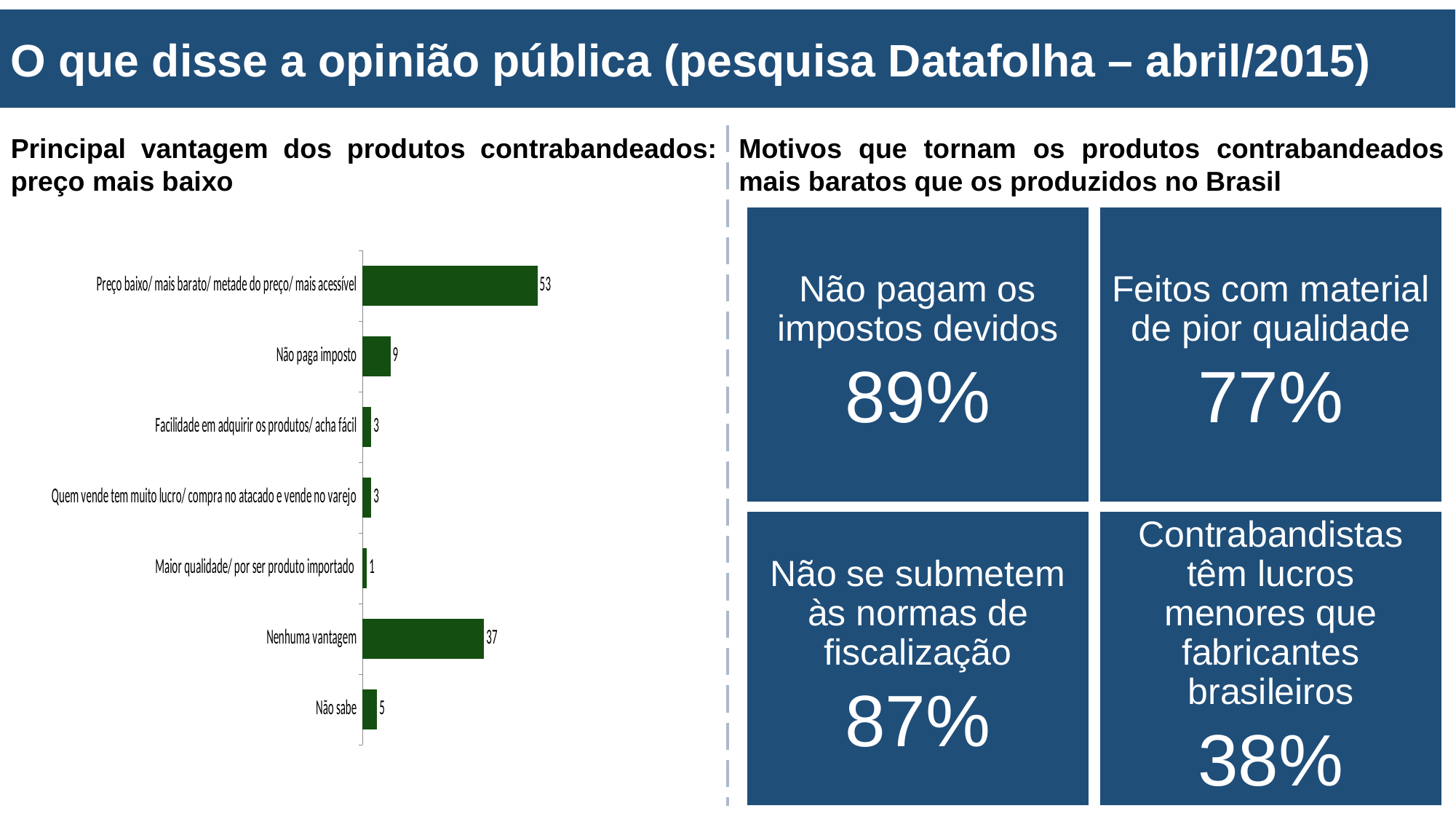
What is the difference between the values for "Preço baixo/ mais barato/ metade do preço/ mais acessível" and "Nenhuma vantagem"? 16 Which category has the lowest value in the bar chart? Maior qualidade/ por ser produto importado What is the value for "Nenhuma vantagem"? 37 What is the value for "Não sabe"? 5 What is the value for "Maior qualidade/ por ser produto importado"? 1 Which is larger, the value for "Não paga imposto" or the value for "Não sabe"? Não paga imposto What is the value for "Não paga imposto"? 9 What colour are the bars in the bar chart? dark green What is the value for "Preço baixo/ mais barato/ metade do preço/ mais acessível"? 53 How many categories does the bar chart show? 7 Which category has the highest value in the bar chart? Preço baixo/ mais barato/ metade do preço/ mais acessível What type of chart is shown on the left side of the slide? bar chart